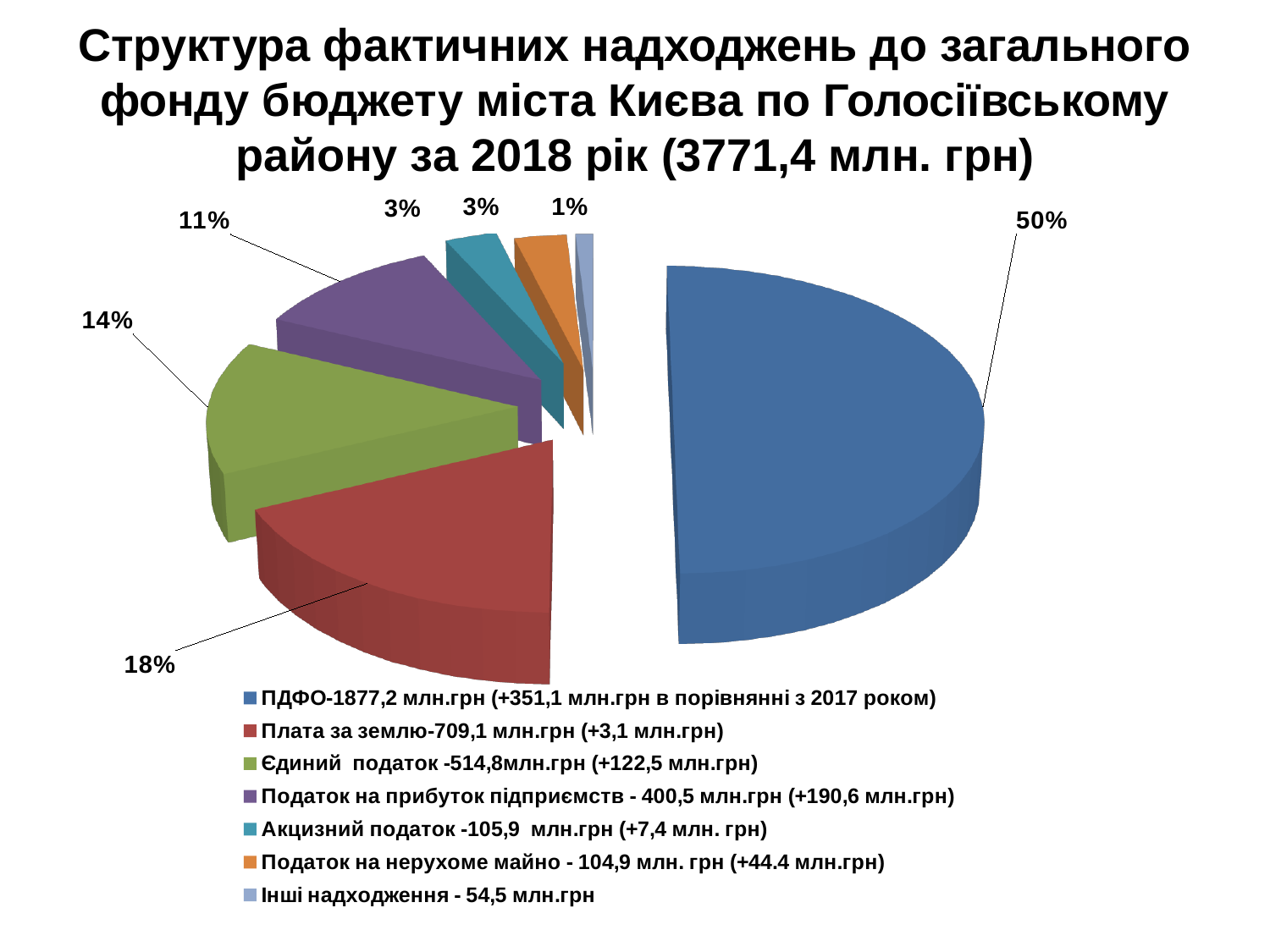
How many slices does the pie chart have? 7 According to the legend, what is the amount for Акцизний податок? 105,9 млн.грн According to the legend, what is the amount for ПДФО? 1877,2 млн.грн What share of the pie does Єдиний податок account for? 14% Which slice is larger: Плата за землю or Єдиний податок? Плата за землю Which category has the largest slice of the pie? ПДФО What share of the pie does ПДФО account for? 50% Which category has the smallest slice of the pie? Інші надходження What share of the pie does Податок на прибуток підприємств account for? 11% What kind of chart is shown on the slide? pie chart What is the difference in percentage points between the ПДФО slice and the Плата за землю slice? 32